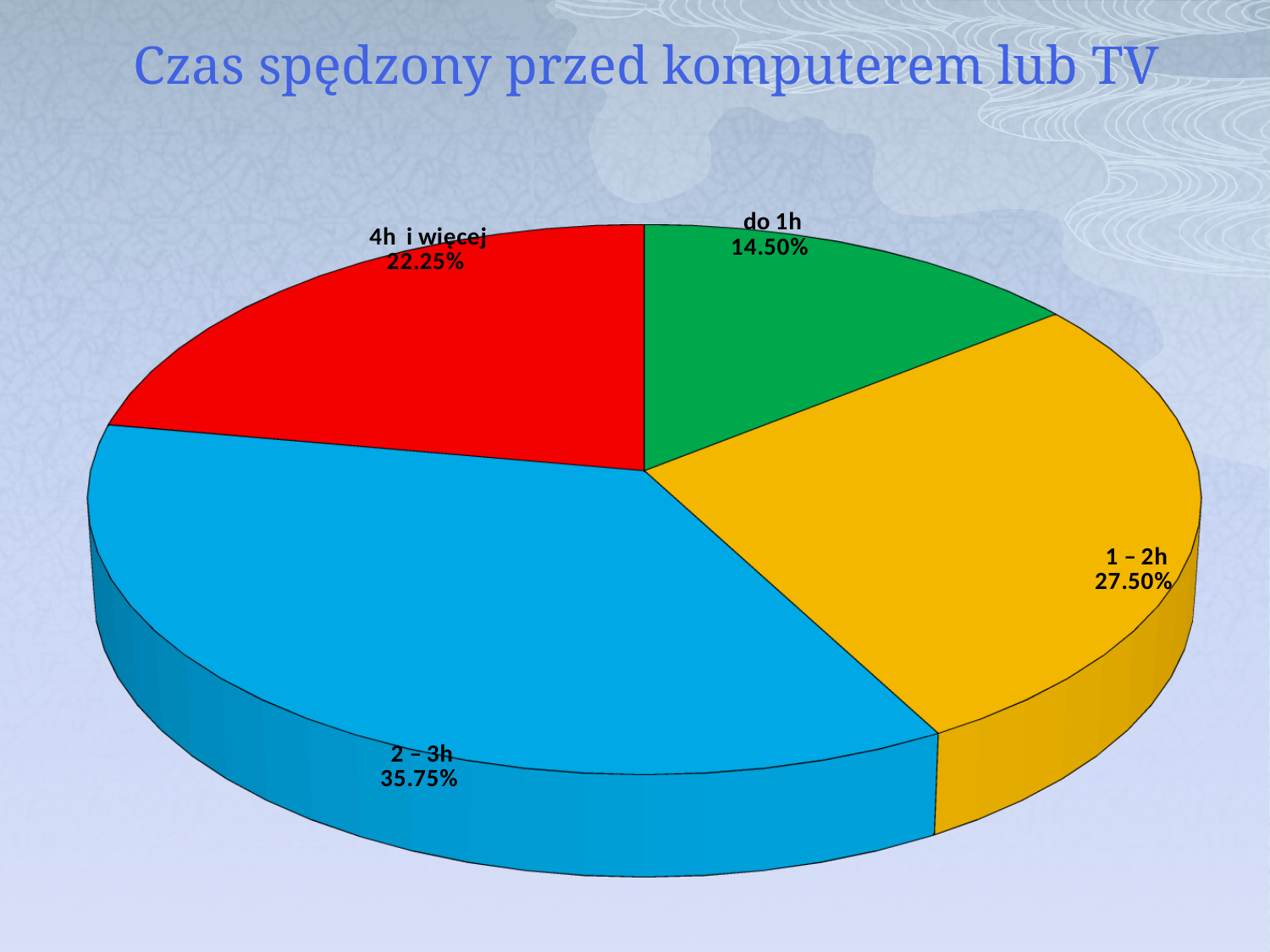
Which category has the smallest share of the pie? do 1h What is the title of the chart? Czas spędzony przed komputerem lub TV What is the value for the '4h i więcej' slice? 22.25% What is the value shown for the 'do 1h' slice? 14.50% What percentage is labelled on the '1 – 2h' slice? 27.50% What kind of chart is shown on the slide? Pie chart Which is larger, the share for '1 – 2h' or for '4h i więcej'? 1 – 2h What share of the pie does the '2 – 3h' slice represent? 35.75% What is the difference between the '1 – 2h' and '4h i więcej' shares? 5.25% How many slices does the pie chart have? 4 What is the difference between the '2 – 3h' and 'do 1h' shares? 21.25% Which category has the largest share of the pie? 2 – 3h